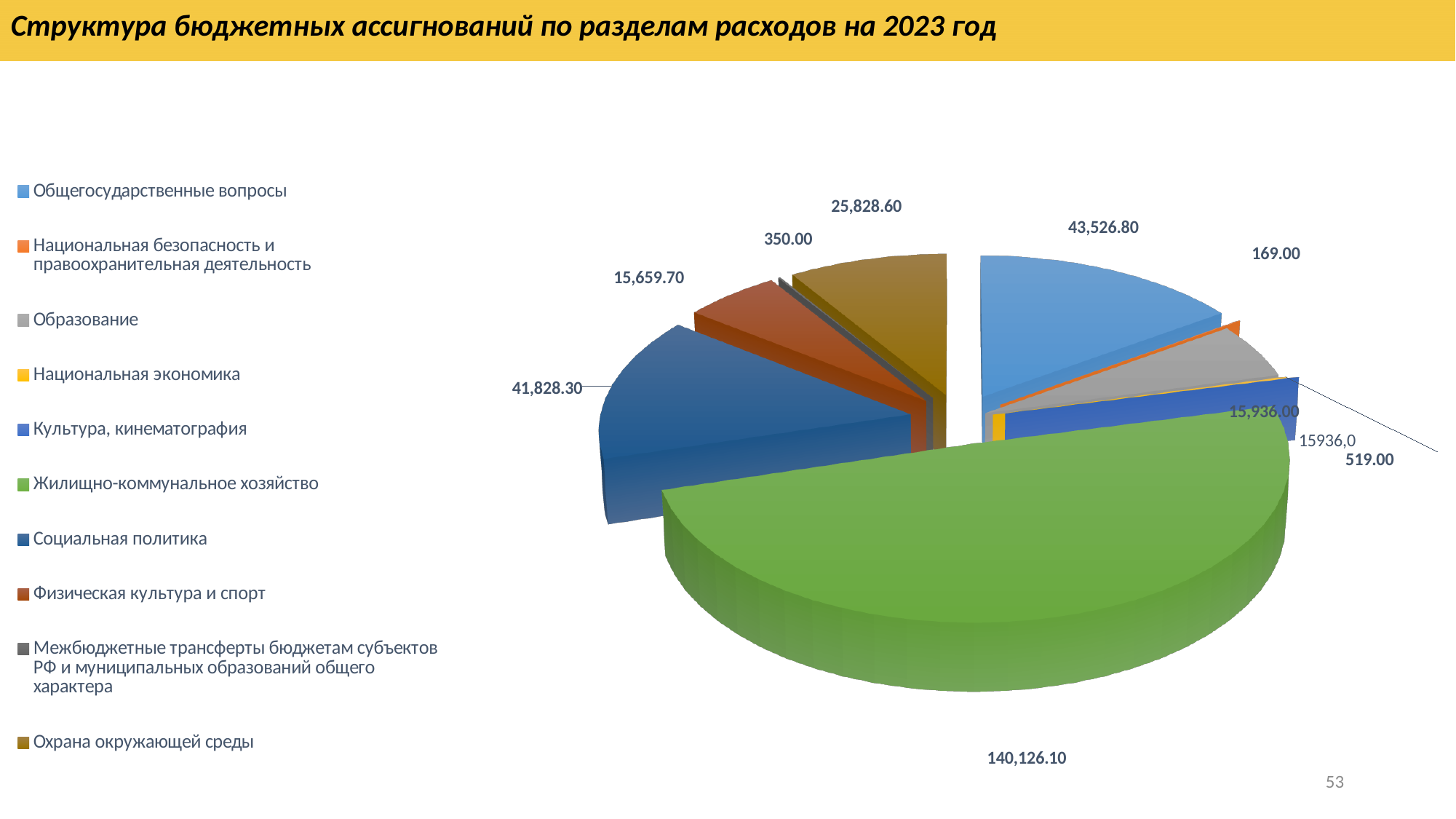
What is the value for Жилищно-коммунальное хозяйство? 140,126.10 How many categories does the legend list? 10 What is the value for Охрана окружающей среды? 25,828.60 Which is larger: the value for Социальная политика or the value for Охрана окружающей среды? Социальная политика What is the value for Национальная безопасность и правоохранительная деятельность? 169.00 What kind of chart is shown on the slide? pie chart What is the value for Физическая культура и спорт? 15,659.70 What is the value for Общегосударственные вопросы? 43,526.80 Which category has the largest slice of the pie? Жилищно-коммунальное хозяйство What is the difference between the values for Общегосударственные вопросы and Социальная политика? 1,698.50 What is the value for Социальная политика? 41,828.30